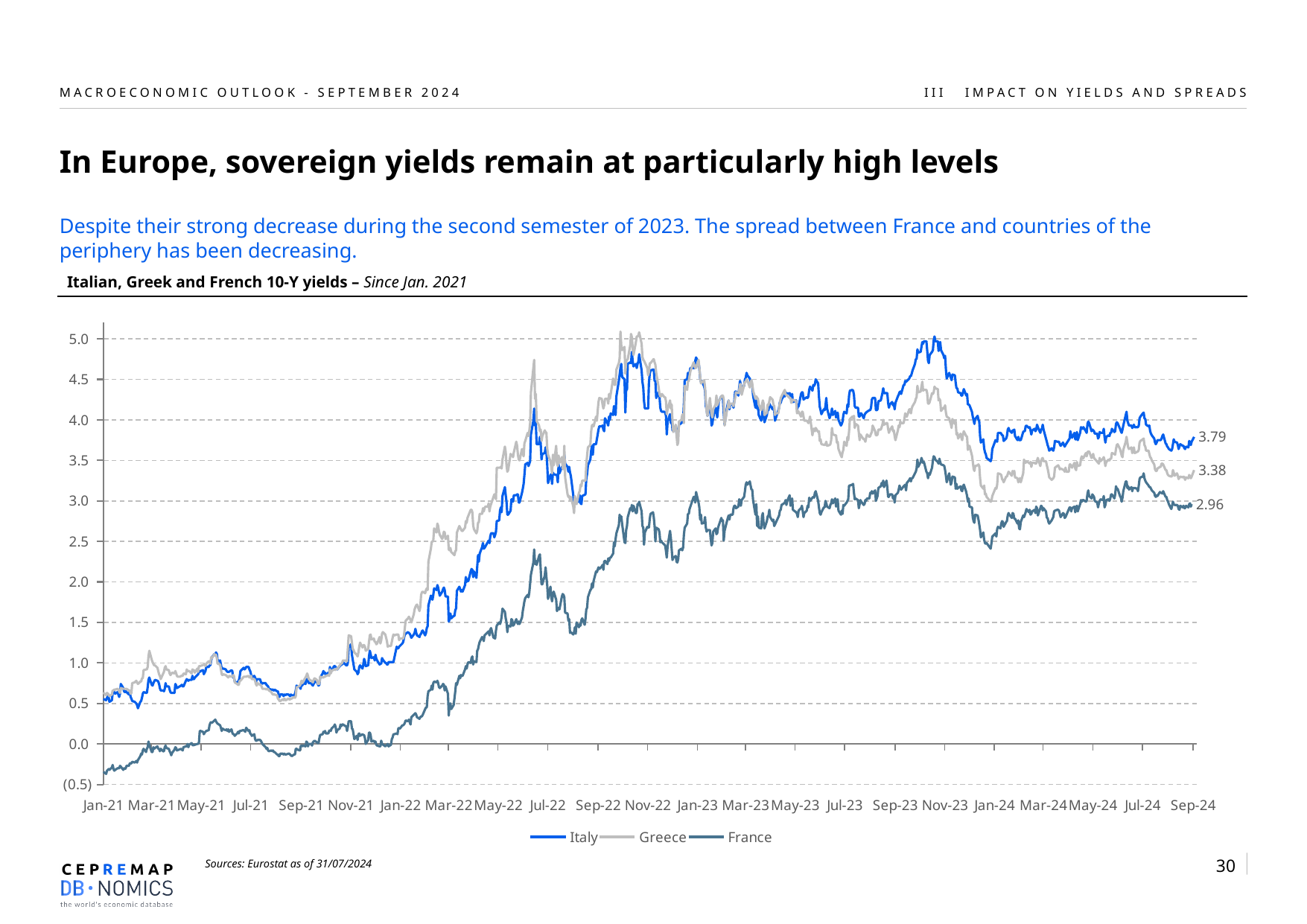
What is the latest value shown for France at the right end of the chart? 2.96 How many series does the legend list? 3 What is the difference between the end-of-chart values for Italy and France? 0.83 Which series has the highest value at the right end of the chart? Italy Which series has the lowest value at the right end of the chart? France What is the difference between the end-of-chart values for Italy and Greece? 0.41 Is the value for France in Jan-21 greater or less than 0.0? less What kind of chart is shown on the slide? line chart What is the latest value shown for Greece at the right end of the chart? 3.38 What is the latest value shown for Italy at the right end of the chart? 3.79 Does the France series rise or fall overall from Jan-21 to Sep-24? rise At the right end of the chart, is the value for Greece larger or smaller than the value for France? larger